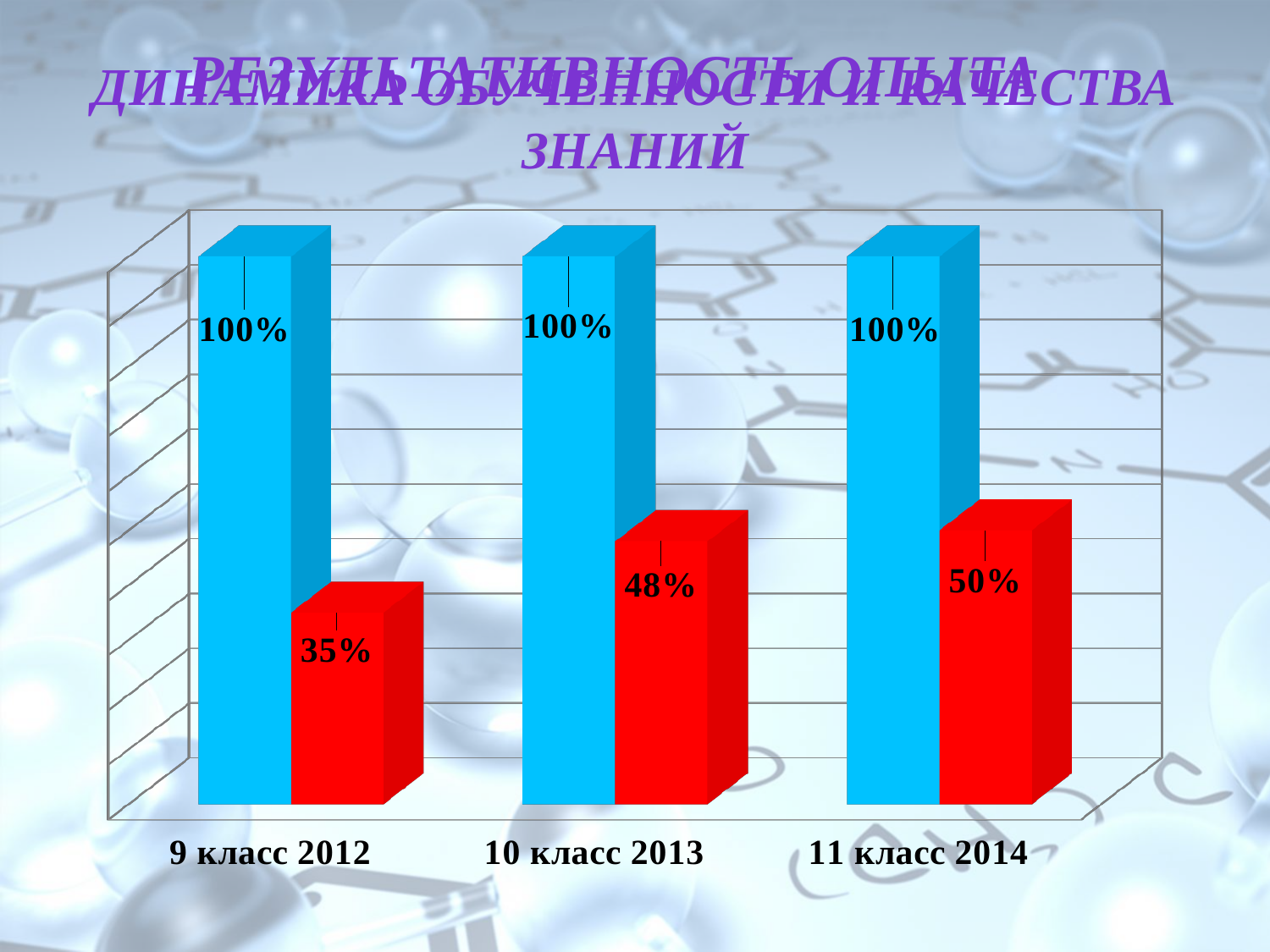
What kind of chart is shown on the slide? bar chart What is the difference between the blue and red bar values for 10 класс 2013? 52% Which is larger, the red bar for 10 класс 2013 or the red bar for 9 класс 2012? 10 класс 2013 What is the value of the blue bar for 10 класс 2013? 100% What is the difference between the red bar values for 11 класс 2014 and 9 класс 2012? 15% What is the value of the red bar for 9 класс 2012? 35% What is the value of the red bar for 11 класс 2014? 50% How many categories are shown on the x axis? 3 What is the value of the red bar for 10 класс 2013? 48% Do the red bar values rise or fall from 9 класс 2012 to 11 класс 2014? rise Which category has the lowest red bar value? 9 класс 2012 Which category has the highest red bar value? 11 класс 2014